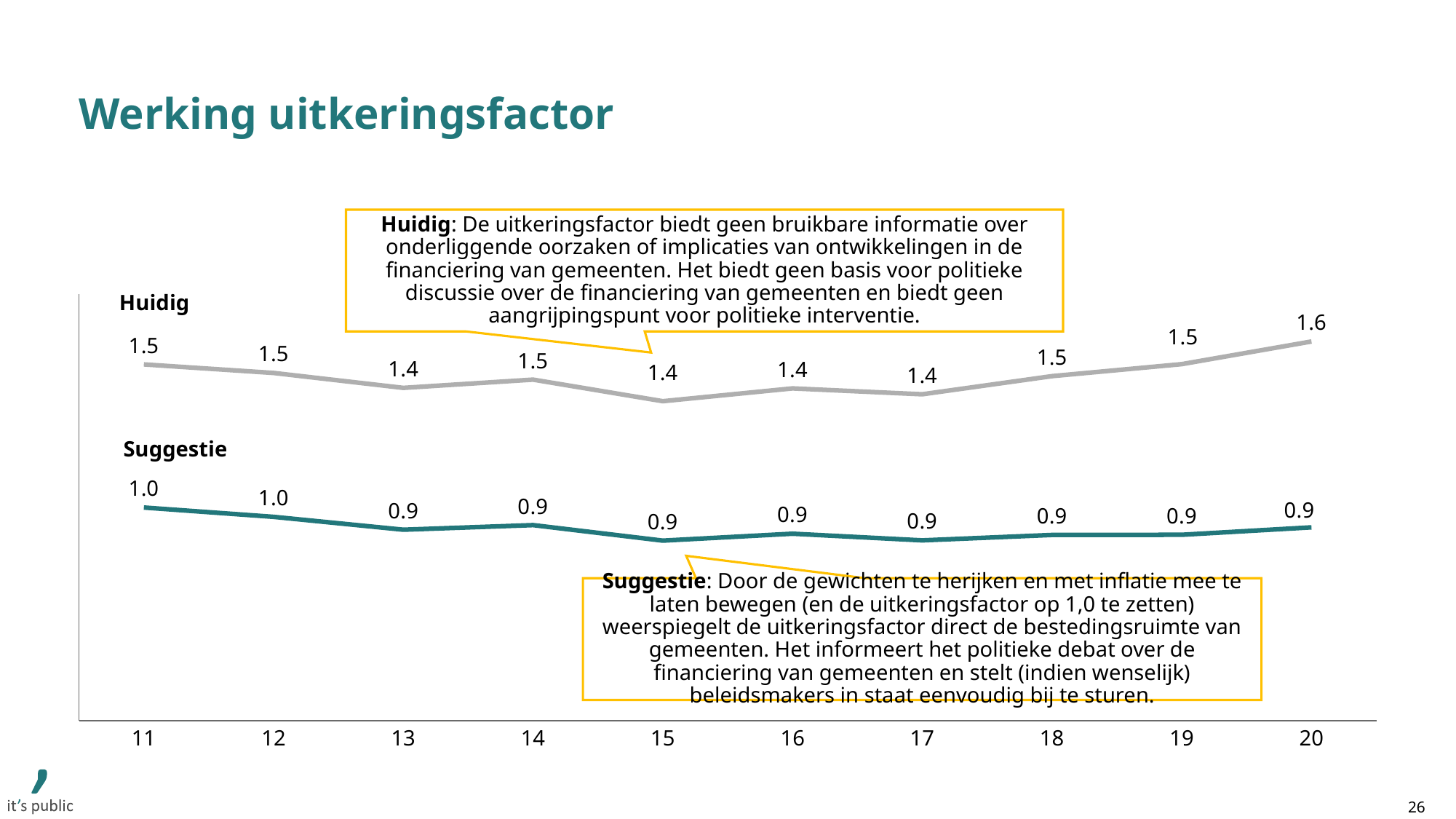
What is the value of the Suggestie series at 17? 0.9 What is the value of the Huidig series at 15? 1.4 What is the title of the slide's chart? Werking uitkeringsfactor What type of chart is shown on the slide? line chart What is the value of the Huidig series at 20? 1.6 How many points are plotted along the x axis for each series? 10 Which series has the larger value at 15, Huidig or Suggestie? Huidig What is the difference between the Huidig and Suggestie values at 11? 0.5 At which x-axis point does the Huidig series reach its highest value? 20 What is the value of the Suggestie series at 11? 1.0 How many series are plotted in the chart? 2 Does the Huidig series rise or fall from 17 to 20? rise